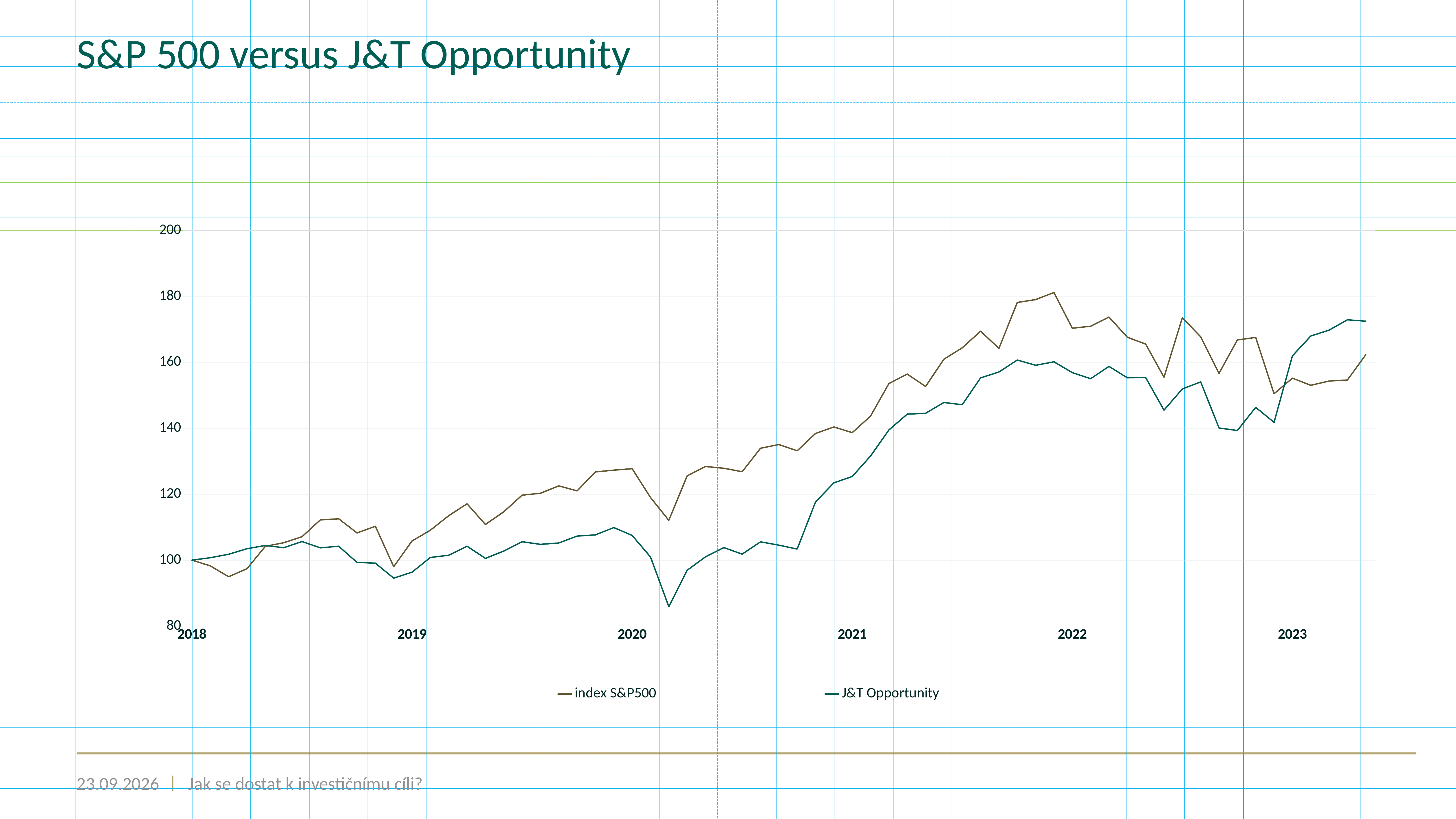
Is the value of J&T Opportunity at the right end of the chart in 2023 greater or less than 160? greater At the right end of the chart in 2023, which series has the higher value, index S&P500 or J&T Opportunity? J&T Opportunity Which two series are listed in the legend? index S&P500 and J&T Opportunity At the 2020 tick, which series has the higher value, index S&P500 or J&T Opportunity? index S&P500 How many year labels are shown on the x axis? 6 Is the highest value of index S&P500 (reached around the end of 2021) greater or less than 160? greater What value do both series start at in 2018? 100 Do the values of J&T Opportunity generally rise or fall from 2018 to 2023? rise What is the title of the chart? S&P 500 versus J&T Opportunity Is the lowest value of J&T Opportunity in early 2020 greater or less than 100? less How many series does the legend list? 2 What kind of chart is shown on the slide? line chart